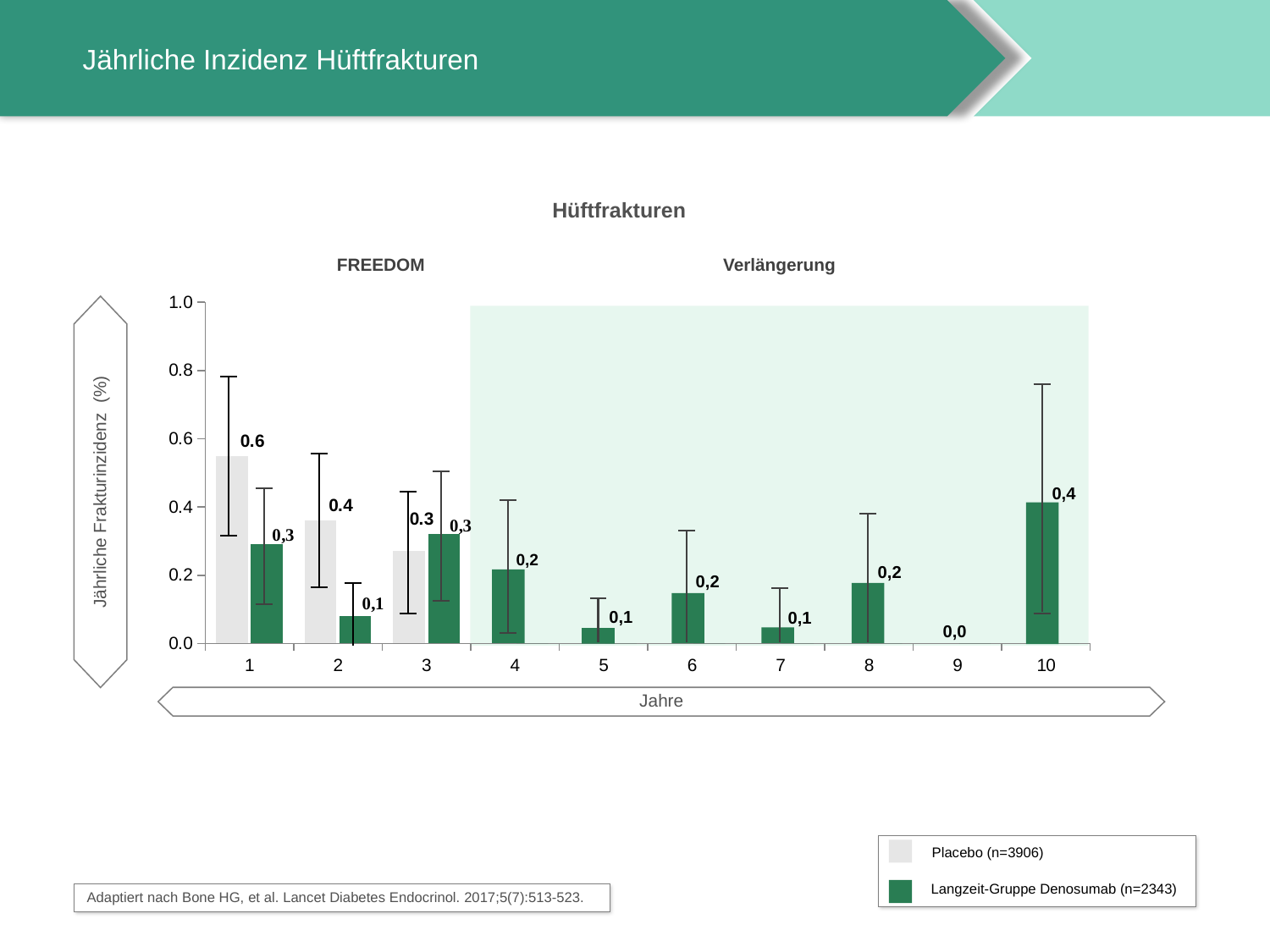
Is the Placebo bar for year 1 greater or less than 0.4? greater What is the value for the Placebo group in year 3? 0.3 What is the difference between the Langzeit-Gruppe Denosumab values in year 10 and year 9? 0,4 How many years are shown on the x axis? 10 In year 2, which group has the higher value, Placebo or Langzeit-Gruppe Denosumab? Placebo What is the value for the Langzeit-Gruppe Denosumab in year 9? 0,0 What kind of chart is shown on the slide? bar chart What is the value for the Langzeit-Gruppe Denosumab in year 10? 0,4 In which year does the Langzeit-Gruppe Denosumab have its lowest value? 9 What is the annual hip fracture incidence for the Placebo group in year 1? 0.6 How many series does the legend list? 2 In which year does the Langzeit-Gruppe Denosumab have its highest value? 10